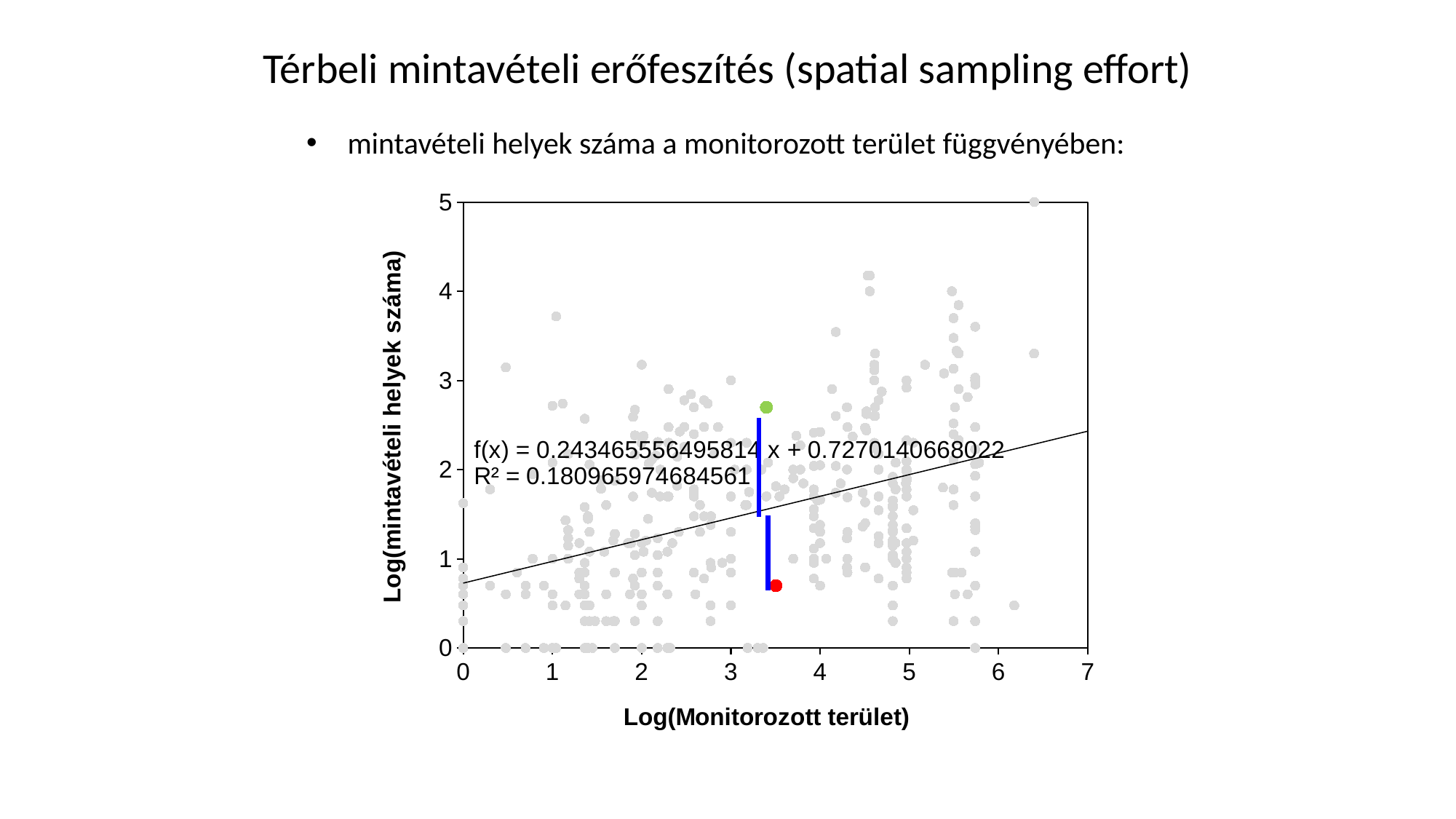
What is the slope of the fitted line f(x) printed on the chart? 0.243465556495814 What R² value is printed on the chart? R² = 0.180965974684561 Is the y value of the green highlighted point greater or less than 2? greater Is the y value of the highest plotted point greater or less than 4? greater What is the maximum value shown on the x axis? 7 What is the label of the y axis of the chart? Log(mintavételi helyek száma) Does the fitted trend line rise or fall as Log(Monitorozott terület) increases? rises What kind of chart is shown on the slide? Scatter chart What is the intercept of the fitted line f(x) printed on the chart? 0.7270140668022 Is the y value of the red highlighted point greater or less than 1? less Which highlighted point has the larger y value, the green one or the red one? the green one What is the label of the x axis of the chart? Log(Monitorozott terület)